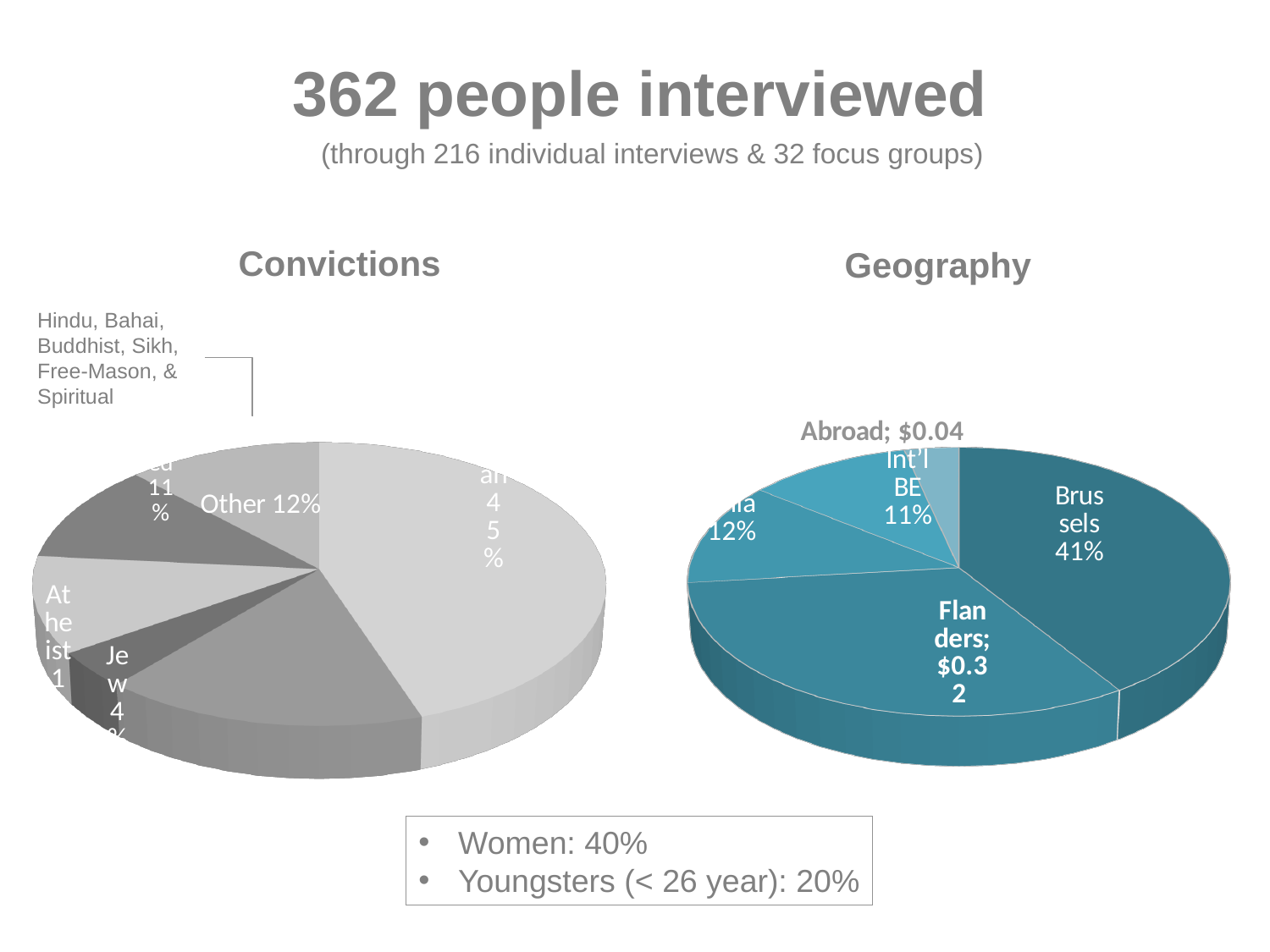
In the Geography chart, which region has the largest slice? Brussels In the Geography chart, what percentage is shown for Int'l BE? 11% In the Geography chart, what percentage is shown for Brussels? 41% In the Convictions chart, what percentage is shown for Other? 12% In the Geography chart, what value is printed on the Flanders slice? $0.32 In the Geography chart, what value is printed for Abroad? $0.04 In the Geography chart, what is the difference in percentage points between Brussels and Int'l BE? 30 What kind of chart is the Convictions chart? pie chart What is the title of the left-hand pie chart? Convictions How many slices does the Geography pie chart have? 5 In the Geography chart, which slice is larger, Brussels or Int'l BE? Brussels What kind of chart is the Geography chart? pie chart